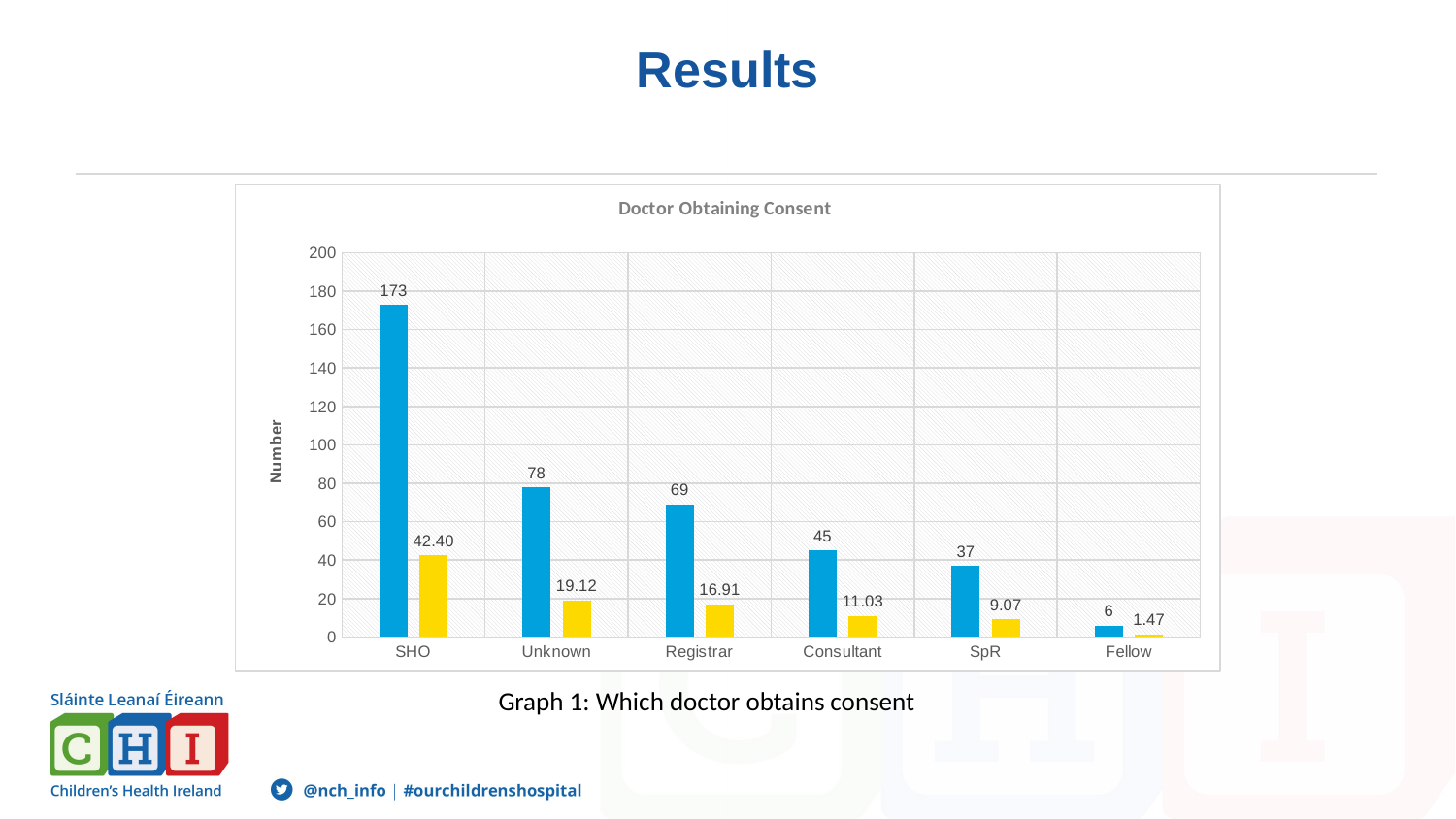
Which has a larger blue bar value, Consultant or SpR? Consultant What kind of chart is shown on the slide? Bar chart How many categories are shown on the x axis? 6 What is the value of the yellow bar for Fellow? 1.47 What is the title of the chart? Doctor Obtaining Consent Do the blue bar values rise or fall from SHO to Fellow along the x axis? Fall What is the value of the blue bar for SHO? 173 What is the value of the blue bar for Registrar? 69 What is the difference between the blue bar values for SHO and Unknown? 95 What is the value of the yellow bar for Consultant? 11.03 Which category has the lowest blue bar? Fellow Which category has the highest blue bar? SHO